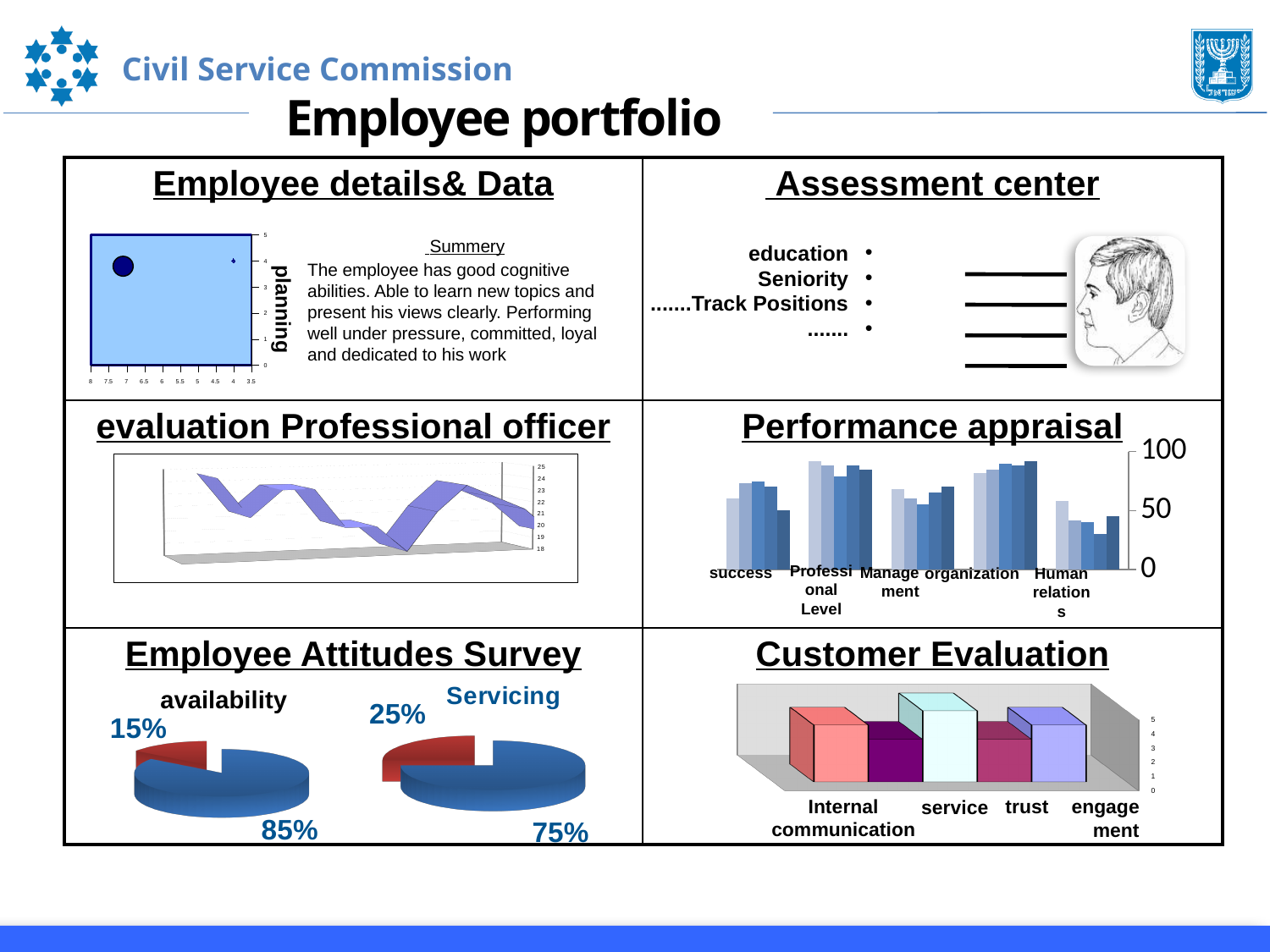
In the Employee Attitudes Survey, which pie chart has the larger red slice, availability or Servicing? Servicing In the Employee Attitudes Survey, what percentage does the blue slice of the Servicing pie chart represent? 75% How many categories are shown on the x axis of the Performance appraisal chart? 5 What kind of chart is the Performance appraisal chart? bar chart How many categories are labelled on the x axis of the Customer Evaluation chart? 4 In the Employee Attitudes Survey, what percentage does the blue slice of the availability pie chart represent? 85% In the Performance appraisal chart, are the bars for Professional Level greater or less than 50? greater In the Employee Attitudes Survey, what percentage does the red slice of the availability pie chart represent? 15% How many pie charts are shown in the Employee Attitudes Survey section? 2 In the Employee Attitudes Survey, what is the difference between the blue slice of the availability pie and the blue slice of the Servicing pie? 10% In the Employee Attitudes Survey, what percentage does the red slice of the Servicing pie chart represent? 25% In the Performance appraisal chart, which category has the lowest bars? Human relations